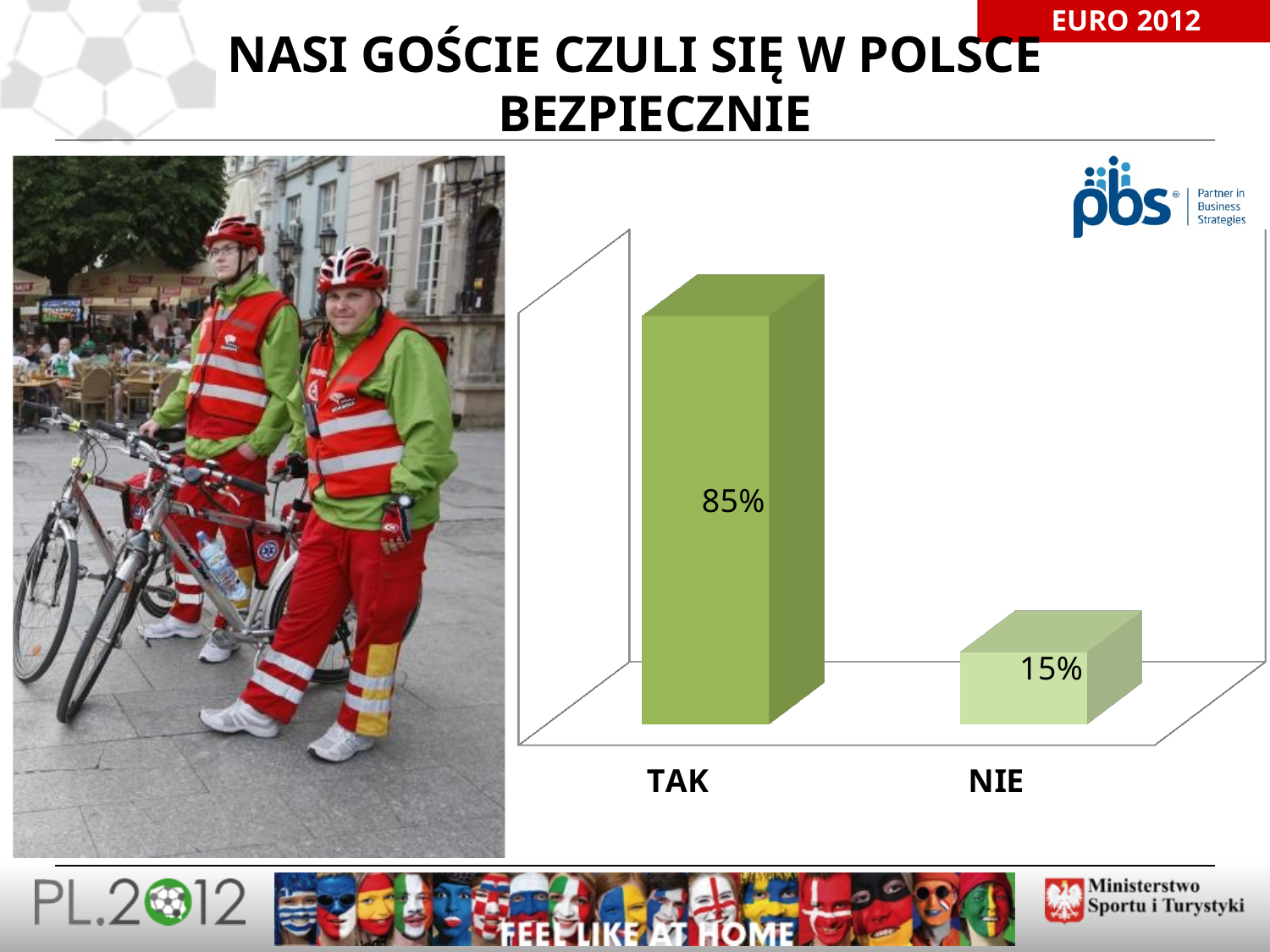
What is the difference between the values for TAK and NIE? 70% What colour are the bars in the chart? green Which is larger, the value for TAK or the value for NIE? TAK Which category has the highest value? TAK What is the title of the slide containing the chart? NASI GOŚCIE CZULI SIĘ W POLSCE BEZPIECZNIE What is the value for NIE? 15% What is the total of the values for TAK and NIE? 100% Which category has the lowest value? NIE What is the value for TAK? 85% What kind of chart is shown on the slide? bar chart How many categories are shown in the chart? 2